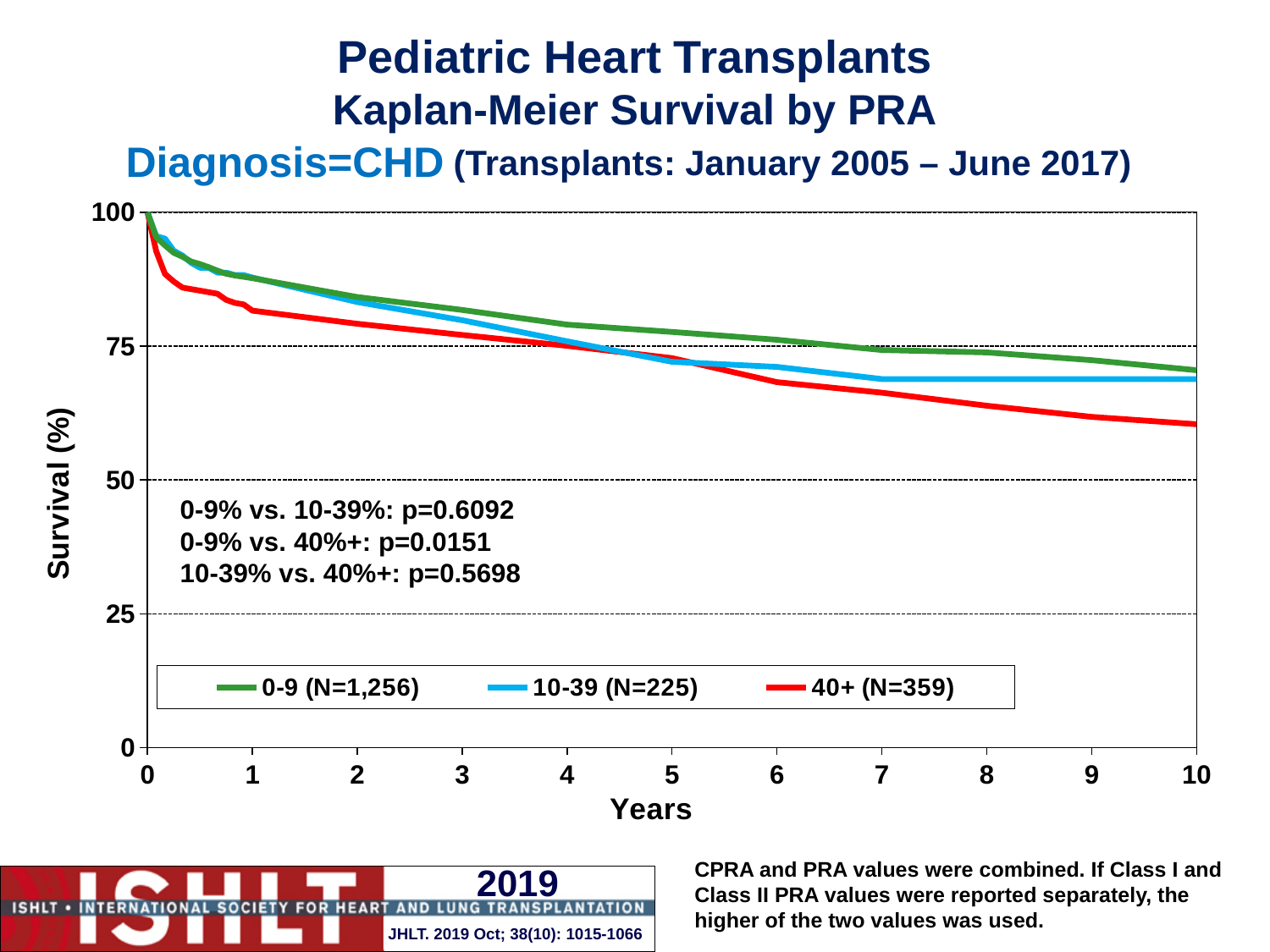
At year 8, which group has higher survival, 0-9 or 40+? 0-9 Which group has the lowest survival at year 10? 40+ (N=359) What is the N for the 10-39 group shown in the legend? 225 What p-value is shown for the comparison 0-9% vs. 40%+? p=0.0151 Is the survival for the 40+ group at year 10 greater or less than 75? less Is the survival for the 10-39 group at year 10 greater or less than 50? greater Is the survival for the 0-9 group at year 1 greater or less than 75? greater What is the survival (%) for the 0-9 group at year 0? 100 What kind of chart is shown on the slide? line chart How many series does the legend list? 3 Do the survival curves rise or fall as years increase? fall